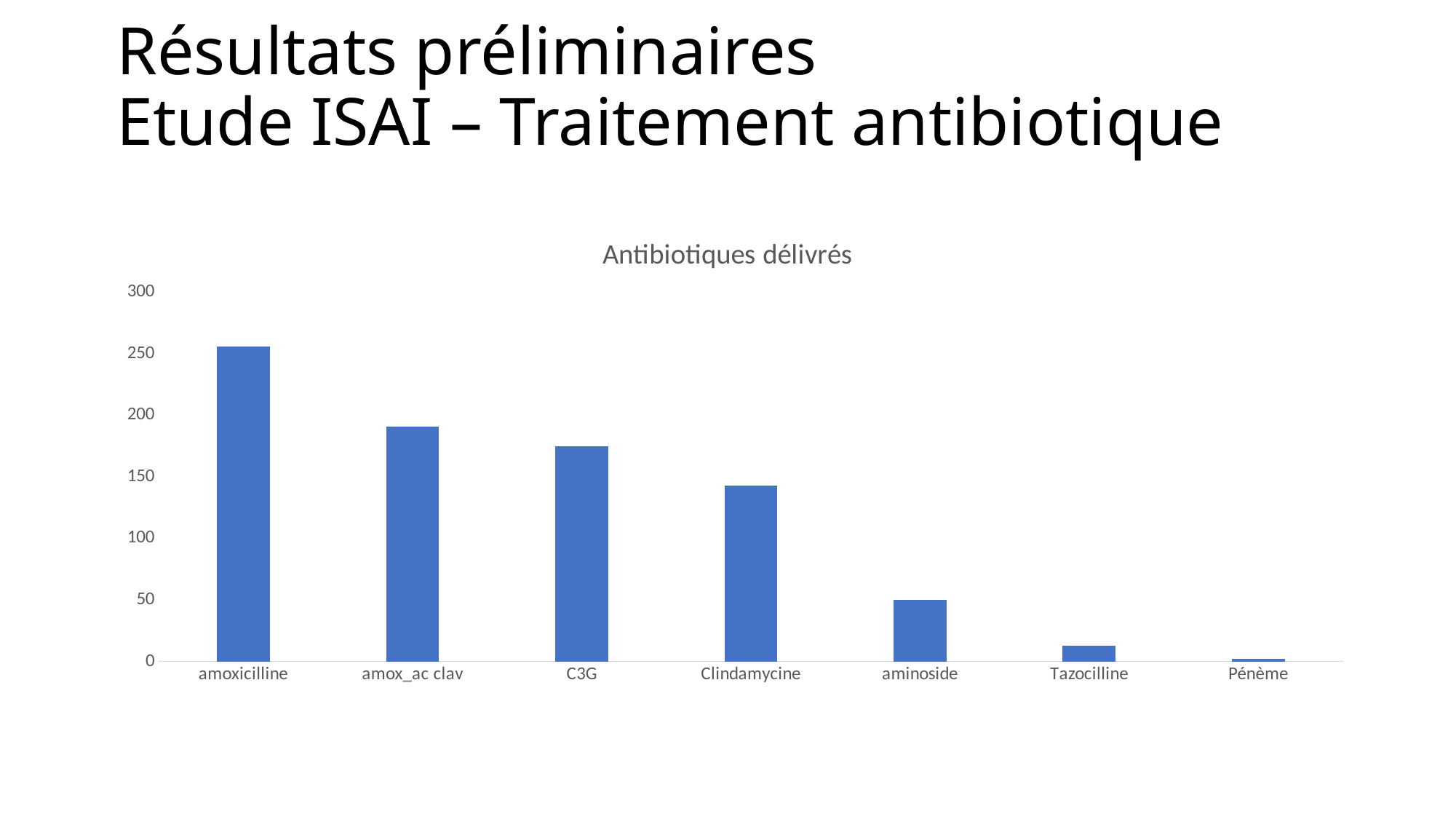
Is the value for Clindamycine greater or less than 150? less Which is larger, the value for C3G or the value for Clindamycine? C3G What is the title of the chart? Antibiotiques délivrés How many antibiotic categories are shown on the x axis? 7 Which antibiotic has the lowest value? Pénème Is the value for C3G greater or less than 150? greater Is the value for amoxicilline greater or less than 200? greater Do the values rise or fall from left to right along the x axis? fall What kind of chart is shown on the slide? bar chart Which antibiotic has the highest value? amoxicilline